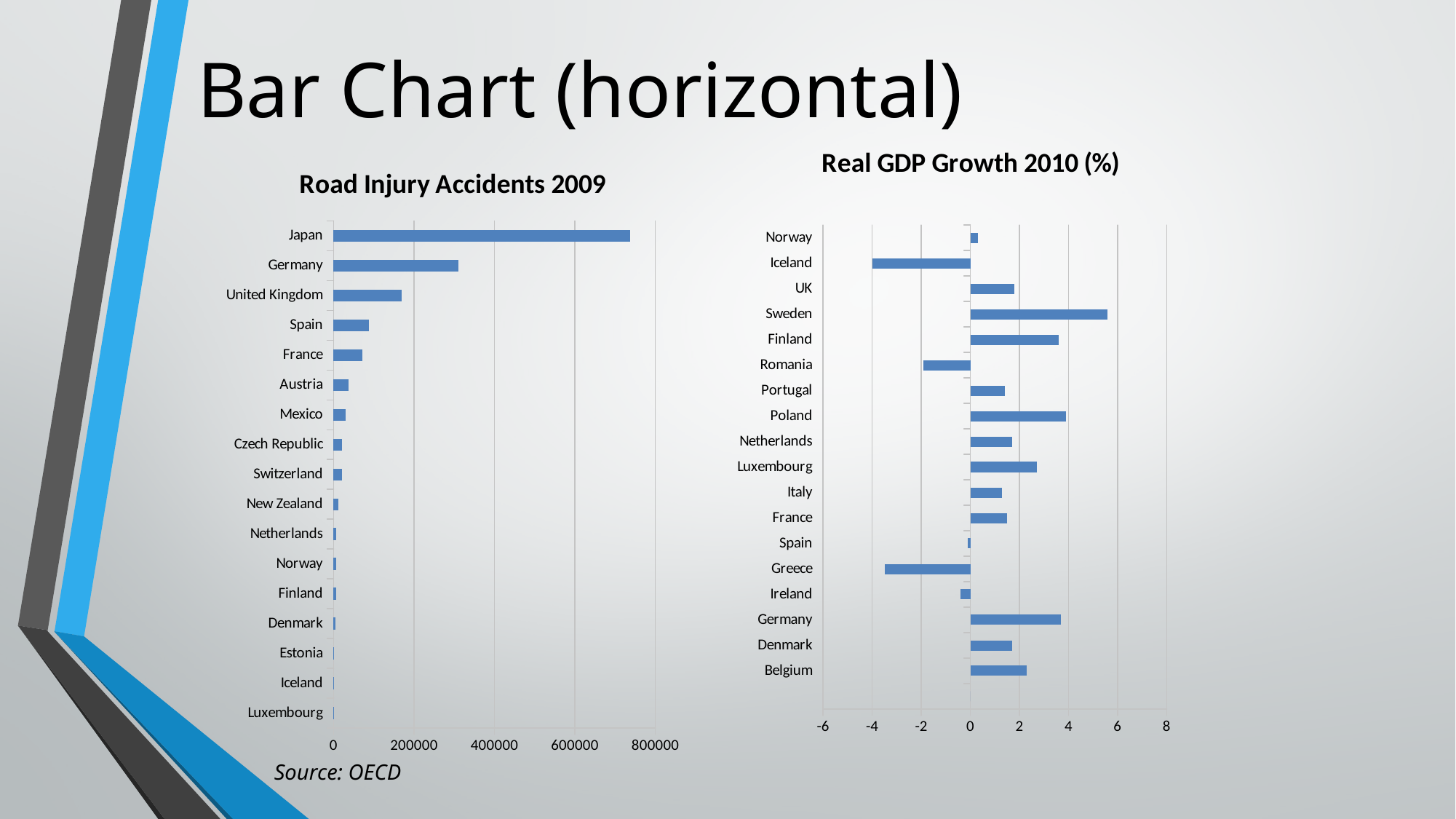
How many countries are shown in the Real GDP Growth 2010 (%) chart? 18 In the Road Injury Accidents 2009 chart, is the value for United Kingdom greater or less than 200000? less In the Real GDP Growth 2010 (%) chart, which country has the lowest value? Iceland In the Real GDP Growth 2010 (%) chart, is the value for Greece greater or less than -2? less In the Real GDP Growth 2010 (%) chart, which has higher GDP growth, Sweden or Finland? Sweden In the Road Injury Accidents 2009 chart, which has more road injury accidents, Germany or Spain? Germany What kind of chart is the Road Injury Accidents 2009 chart? bar chart In the Road Injury Accidents 2009 chart, is the value for Germany greater or less than 400000? less How many countries are shown in the Road Injury Accidents 2009 chart? 17 In the Real GDP Growth 2010 (%) chart, which country has the highest value? Sweden In the Road Injury Accidents 2009 chart, which country has the highest value? Japan